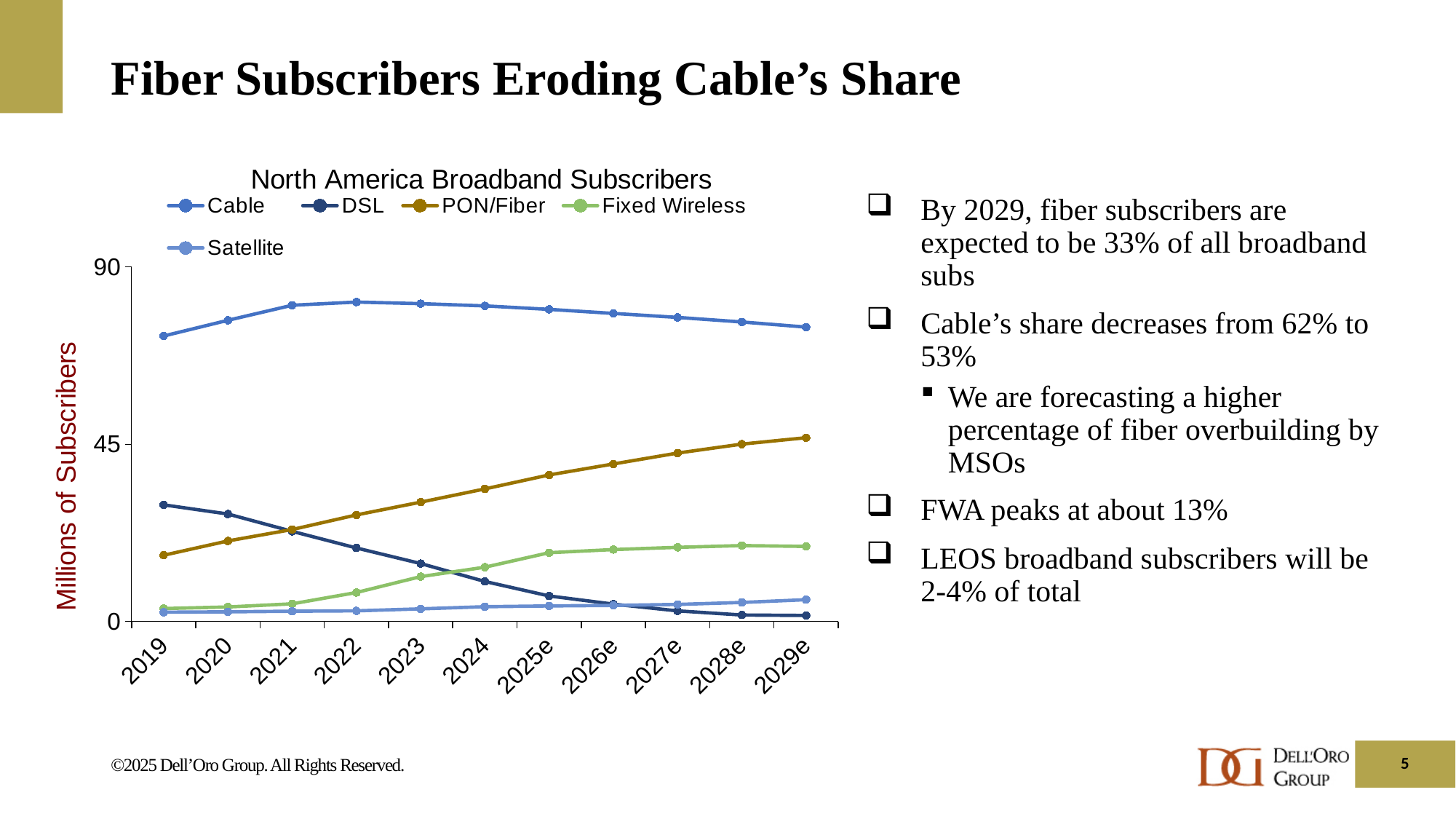
In 2019, which is larger, DSL or PON/Fiber? DSL Is the value for Cable in 2019 greater or less than 45? greater Is the value for PON/Fiber in 2019 greater or less than 45? less What is the label on the vertical axis of the chart? Millions of Subscribers How many years are shown on the x axis of the chart? 11 What is the title of the chart? North America Broadband Subscribers Which series has the lowest value in 2029e? DSL How many series does the chart legend list? 5 What kind of chart is shown on the slide? Line chart Does the DSL series rise or fall from 2019 to 2029e? Fall Does the PON/Fiber series rise or fall from 2019 to 2029e? Rise Which series has the highest value in 2029e? Cable